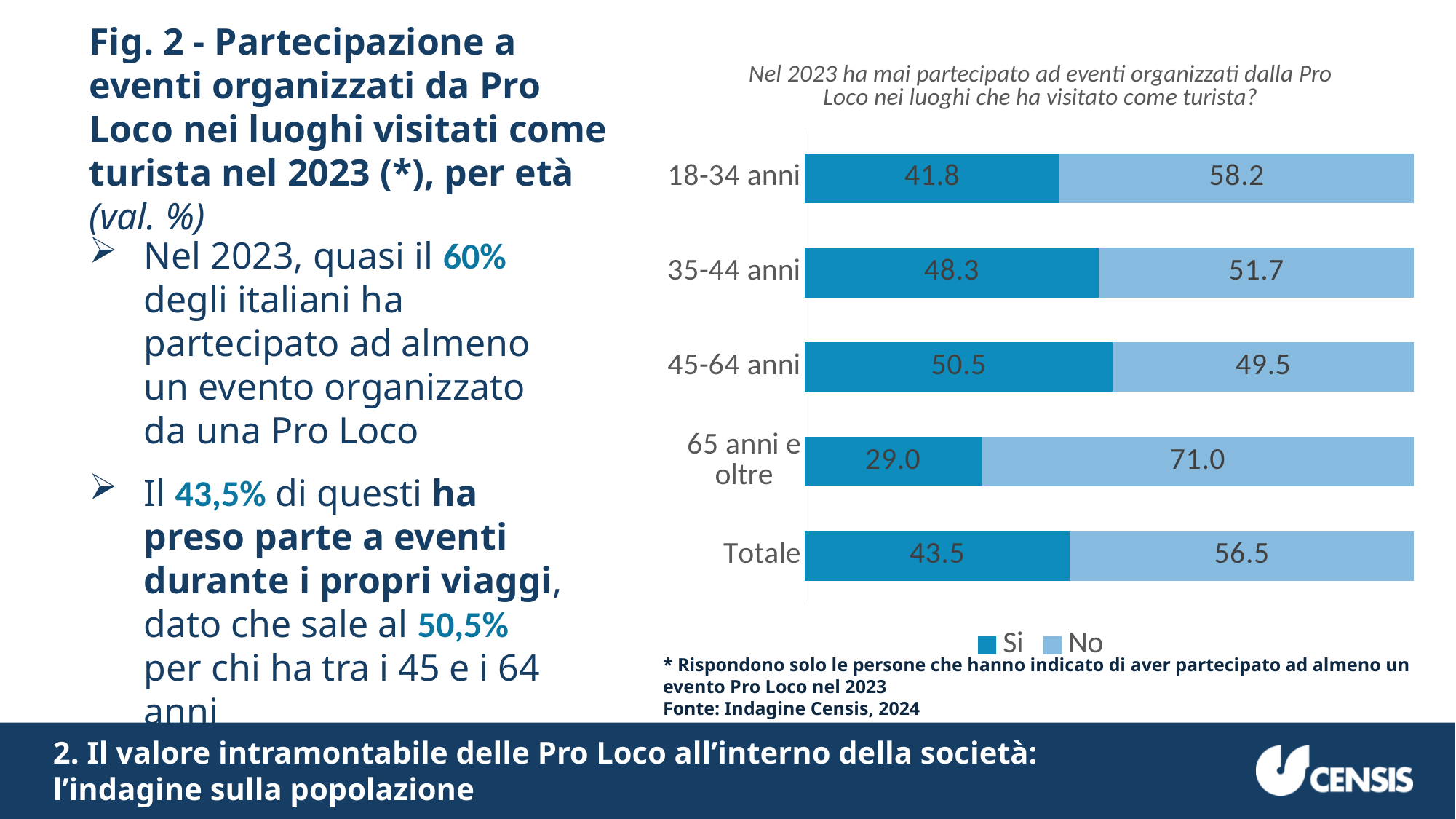
What kind of chart is shown on the slide? Stacked bar chart Which age category has the highest 'Si' value? 45-64 anni Which is larger: the 'Si' value for 35-44 anni or the 'Si' value for 18-34 anni? 35-44 anni What is the difference between the 'No' value for 65 anni e oltre and the 'No' value for 18-34 anni? 12.8 How many series does the legend list? 2 How many categories are shown on the chart? 5 What is the 'No' value for the 65 anni e oltre category? 71.0 What is the total of the stacked bar for 45-64 anni? 100.0 What is the 'Si' value for the 18-34 anni category? 41.8 What is the 'Si' value for Totale? 43.5 Which age category has the lowest 'Si' value? 65 anni e oltre What are the two legend entries of the chart? Si and No